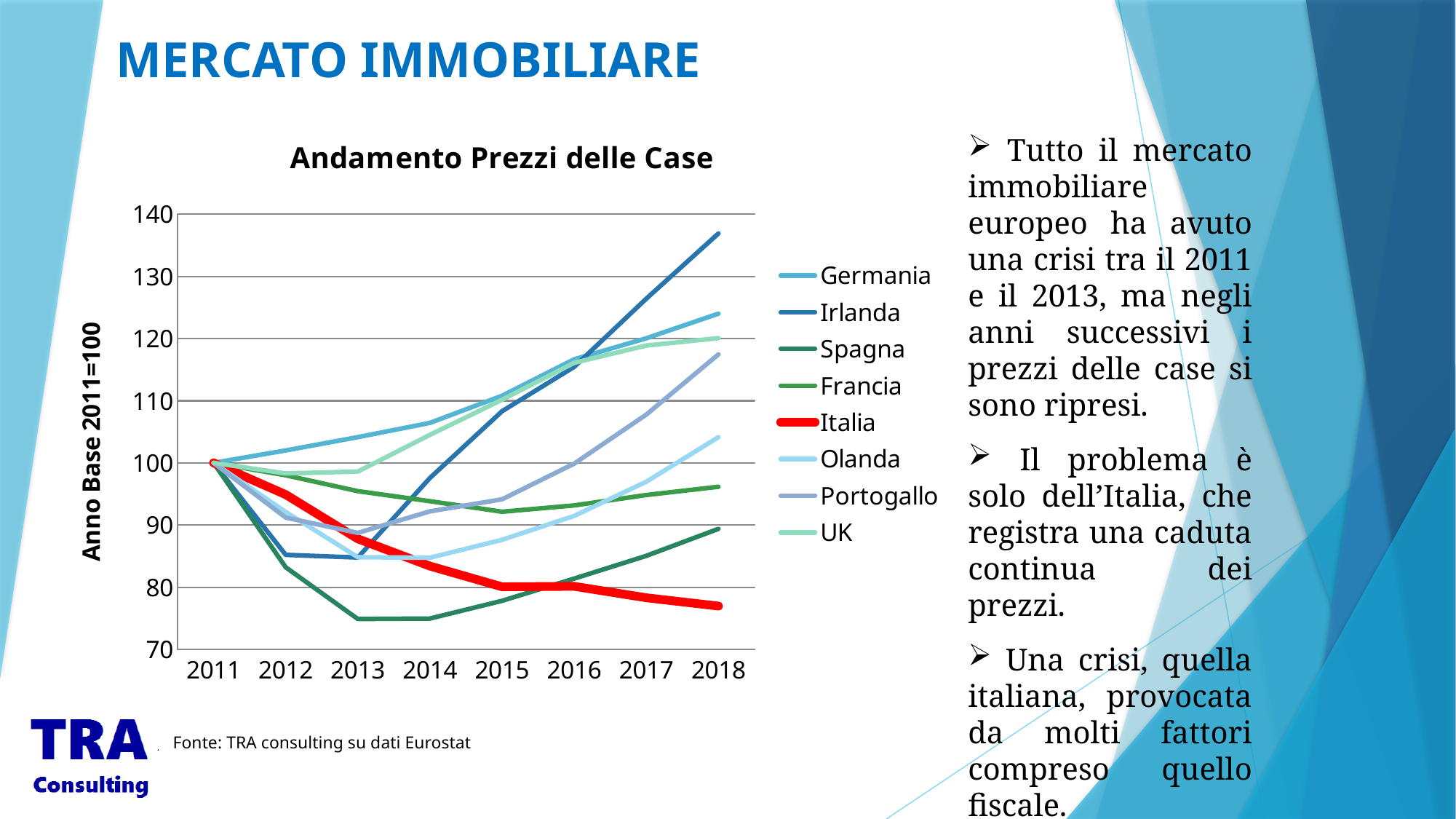
Which country has the lowest value in 2018? Italia How many years are shown on the x axis? 8 What is the value for Italia in 2011? 100 What kind of chart is shown on the slide? line chart Is the value for Irlanda in 2018 greater or less than 130? greater What is the title of the chart? Andamento Prezzi delle Case Does the value for Italia rise or fall from 2011 to 2018? fall In 2013, which is larger: the value for Italia or the value for Spagna? Italia Is the value for Italia in 2018 greater or less than 80? less Is the value for Spagna in 2013 greater or less than 80? less Which country has the highest value in 2018? Irlanda How many series does the legend list? 8